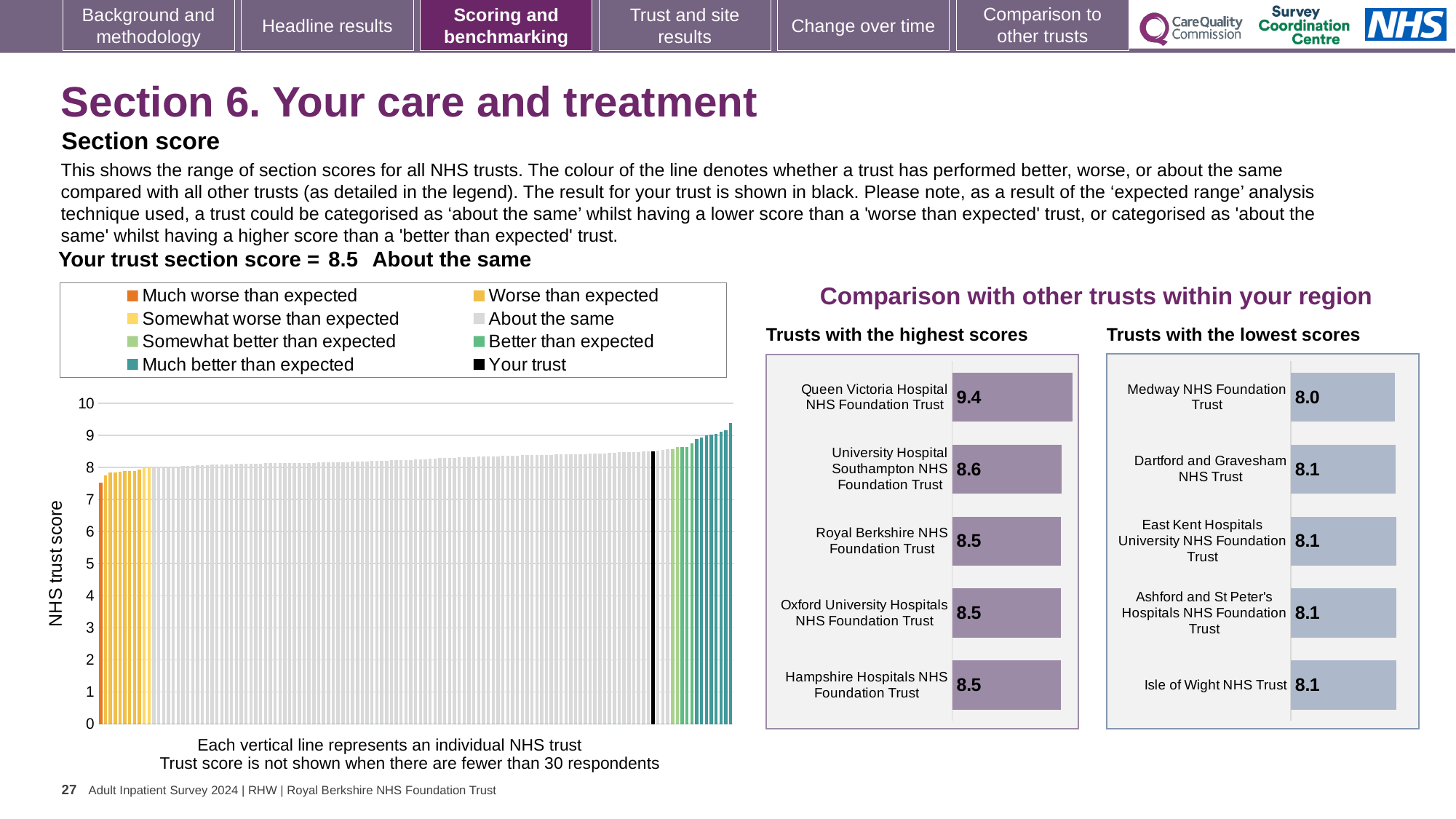
How many entries does the legend of the 'NHS trust score' chart on the left list? 8 What kind of chart is the 'NHS trust score' chart on the left of the slide? bar chart In the 'Trusts with the highest scores' chart, what is the difference between the scores of Queen Victoria Hospital NHS Foundation Trust and University Hospital Southampton NHS Foundation Trust? 0.8 How many trusts are shown in the 'Trusts with the highest scores' chart? 5 According to the slide, what is your trust's section score for Section 6? 8.5 How many trusts are shown in the 'Trusts with the lowest scores' chart? 5 In the 'Trusts with the highest scores' chart, what is the score for Queen Victoria Hospital NHS Foundation Trust? 9.4 In the 'Trusts with the lowest scores' chart, what is the score for Medway NHS Foundation Trust? 8.0 In the 'Trusts with the highest scores' chart, which trust has the highest score? Queen Victoria Hospital NHS Foundation Trust In the 'Trusts with the highest scores' chart, which has the larger score: University Hospital Southampton NHS Foundation Trust or Royal Berkshire NHS Foundation Trust? University Hospital Southampton NHS Foundation Trust In the 'Trusts with the lowest scores' chart, what is the difference between the scores of Dartford and Gravesham NHS Trust and Medway NHS Foundation Trust? 0.1 In the 'Trusts with the lowest scores' chart, which trust has the lowest score? Medway NHS Foundation Trust